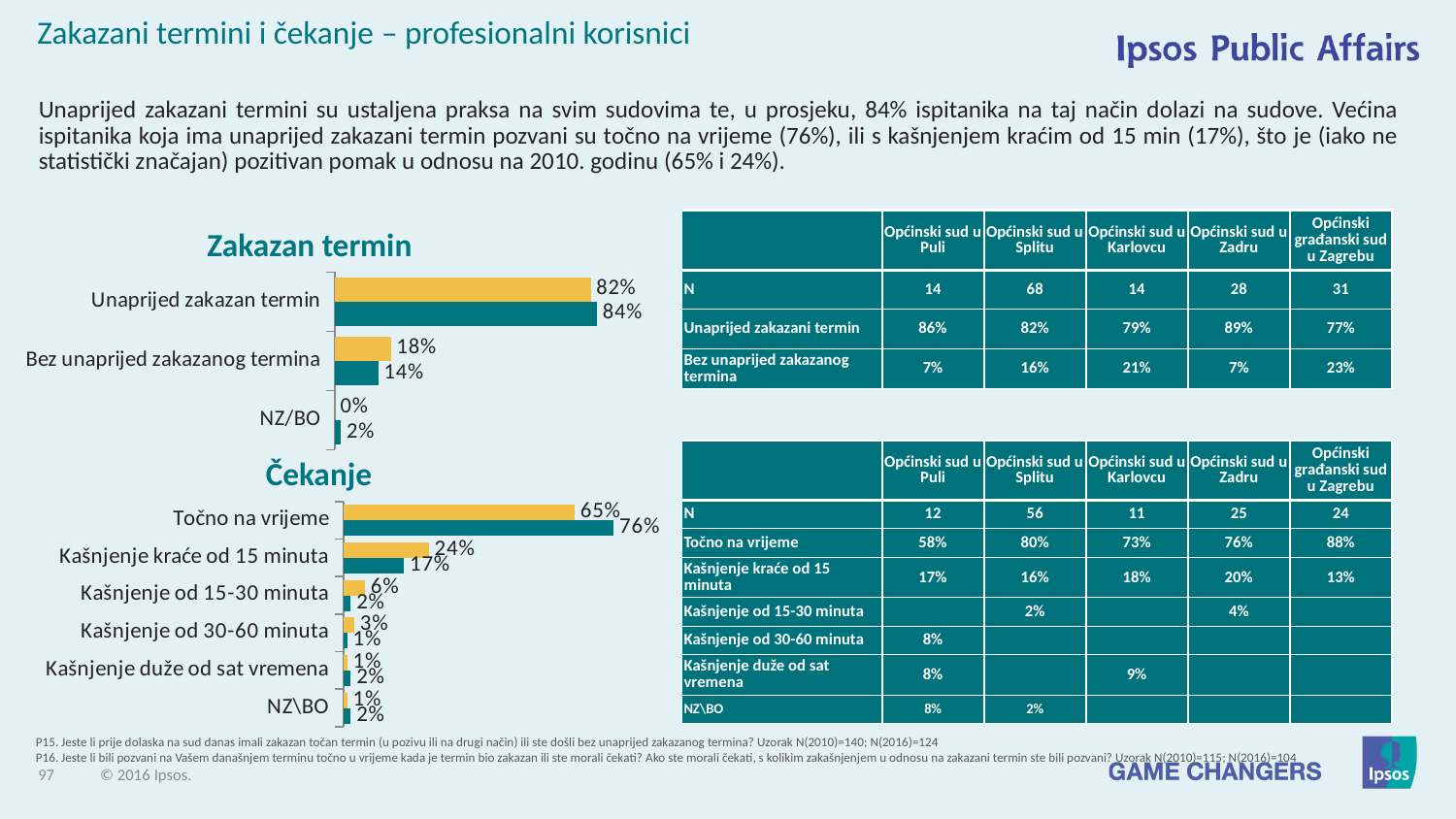
In the 'Čekanje' chart, which category has the highest value? Točno na vrijeme In the 'Čekanje' chart, which is larger for 'Kašnjenje kraće od 15 minuta': the yellow bar or the teal bar? the yellow bar In the 'Zakazan termin' chart, what is the value of the yellow bar for 'Bez unaprijed zakazanog termina'? 18% In the 'Čekanje' chart, what is the difference between the teal and yellow bars for 'Točno na vrijeme'? 11% In the 'Čekanje' chart, what is the value of the teal bar for 'Točno na vrijeme'? 76% In the 'Zakazan termin' chart, what is the difference between the yellow and teal bars for 'Bez unaprijed zakazanog termina'? 4% In the 'Zakazan termin' chart, what is the value of the yellow bar for 'NZ/BO'? 0% In the 'Čekanje' chart, what is the value of the yellow bar for 'Kašnjenje kraće od 15 minuta'? 24% What type of chart is the 'Zakazan termin' chart? bar chart In the 'Čekanje' chart, what is the value of the yellow bar for 'Kašnjenje od 15-30 minuta'? 6% In the 'Čekanje' chart, how many categories are shown? 6 In the 'Zakazan termin' chart, what is the value of the teal bar for 'Unaprijed zakazan termin'? 84%